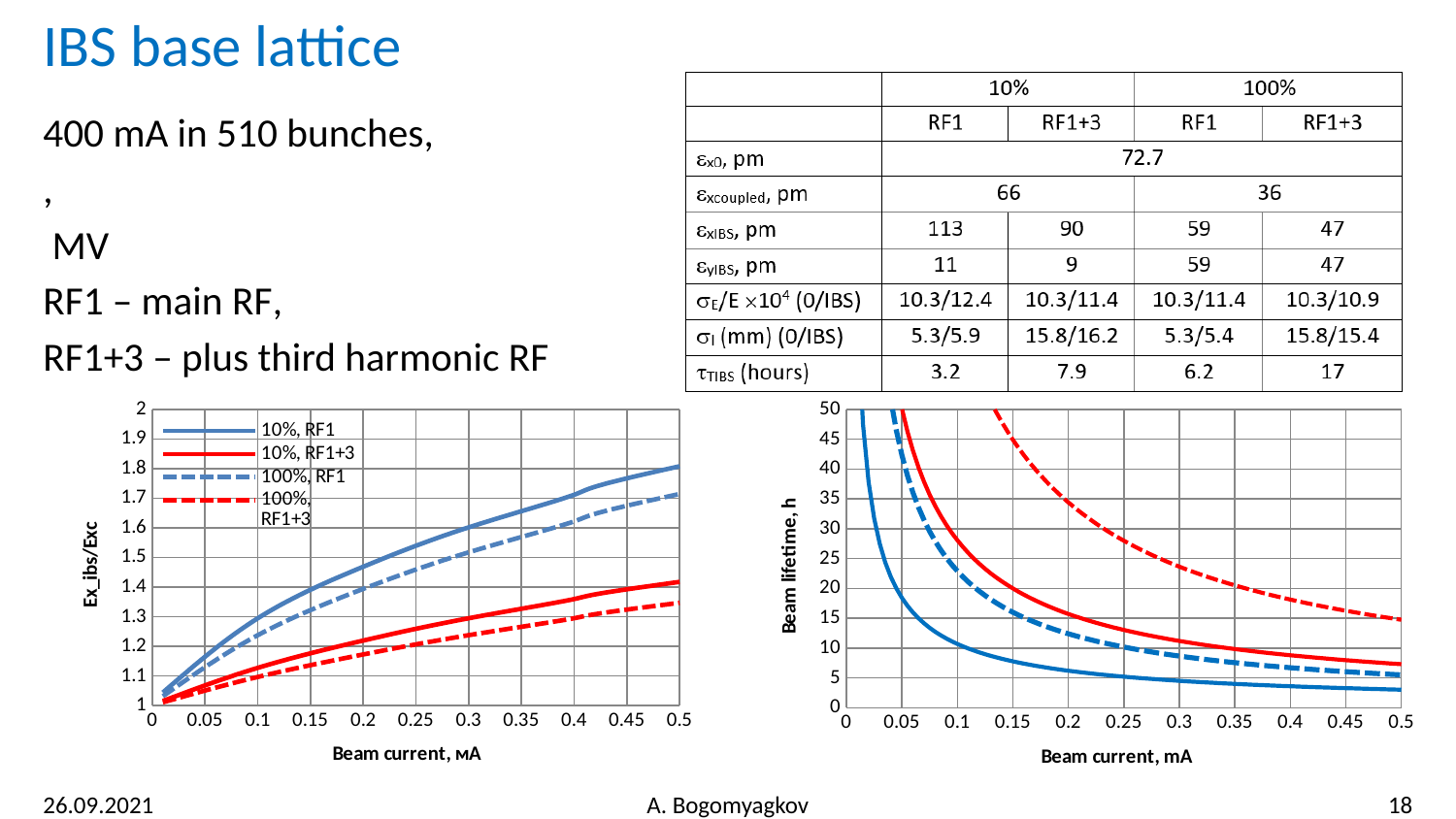
In the right chart, do the beam lifetime values rise or fall as beam current increases? fall In the left chart, which series has the highest value at a beam current of 0.5? 10%, RF1 What type of chart is the left chart (Ex_ibs/Exc vs beam current)? line chart In the left chart, which series has the lowest value at a beam current of 0.5? 100%, RF1+3 What is the y-axis title of the right chart? Beam lifetime, h What is the y-axis title of the left chart? Ex_ibs/Exc In the left chart, is the value of the 100%, RF1+3 series at a beam current of 0.5 greater or less than 1.4? less In the left chart, do the values of the series rise or fall as beam current increases? rise In the left chart, is the value of the 10%, RF1 series at a beam current of 0.5 greater or less than 1.7? greater How many series does the legend of the left chart list? 4 In the left chart, which is larger at a beam current of 0.3: the 10%, RF1 series or the 100%, RF1 series? 10%, RF1 What type of chart is the right chart (Beam lifetime vs beam current)? line chart